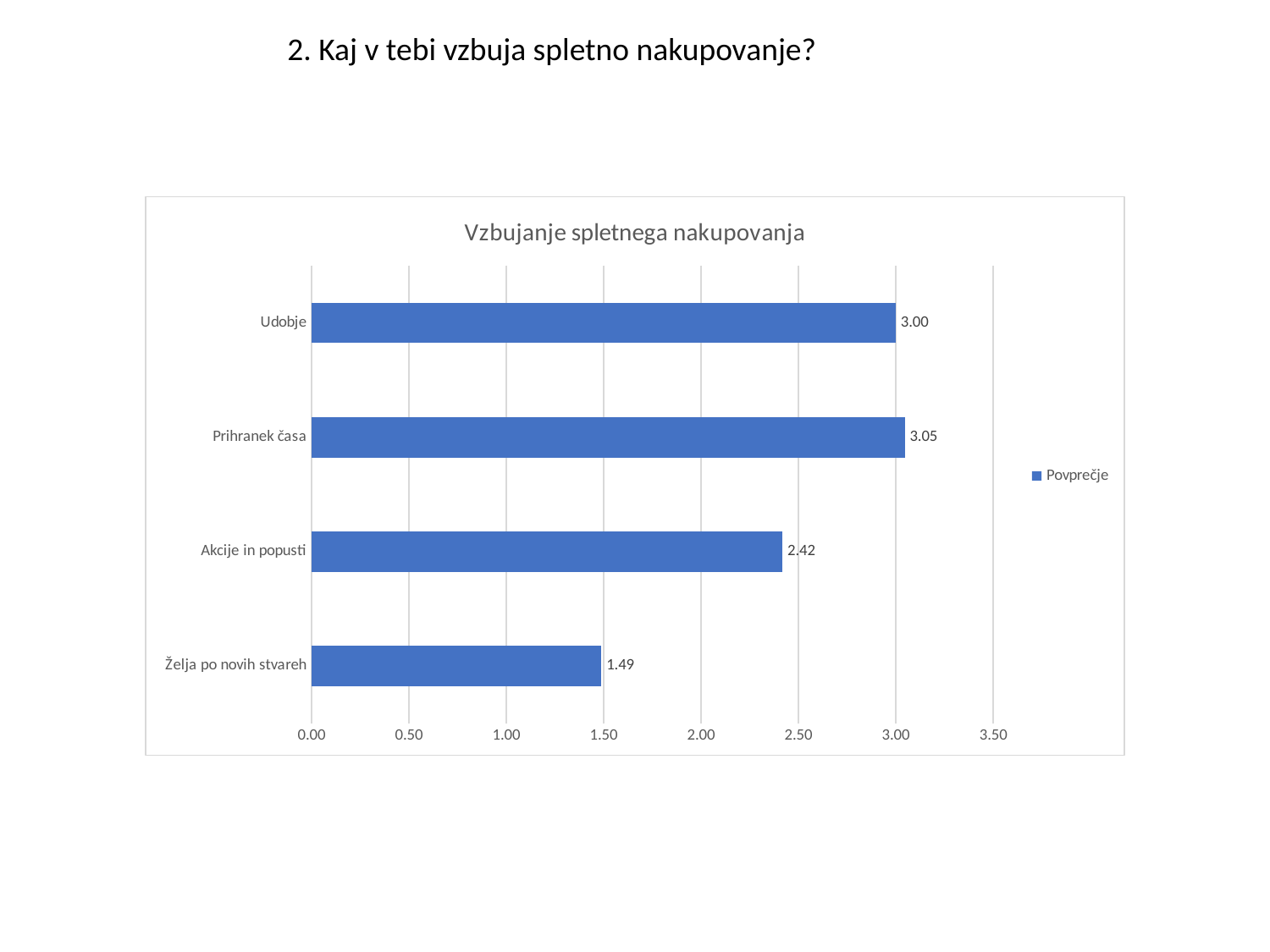
What kind of chart is shown on the slide? Bar chart What is the difference between the values for Udobje and Želja po novih stvareh? 1.51 What is the value for Želja po novih stvareh? 1.49 Is the value for Akcije in popusti greater or less than 2.00? greater Which is larger, the value for Akcije in popusti or the value for Želja po novih stvareh? Akcije in popusti What is the difference between the values for Prihranek časa and Akcije in popusti? 0.63 What is the value for Udobje? 3.00 How many categories are shown in the chart? 4 Which category has the lowest value? Želja po novih stvareh What is the value for Akcije in popusti? 2.42 What is the value for Prihranek časa? 3.05 What is the title of the chart? Vzbujanje spletnega nakupovanja